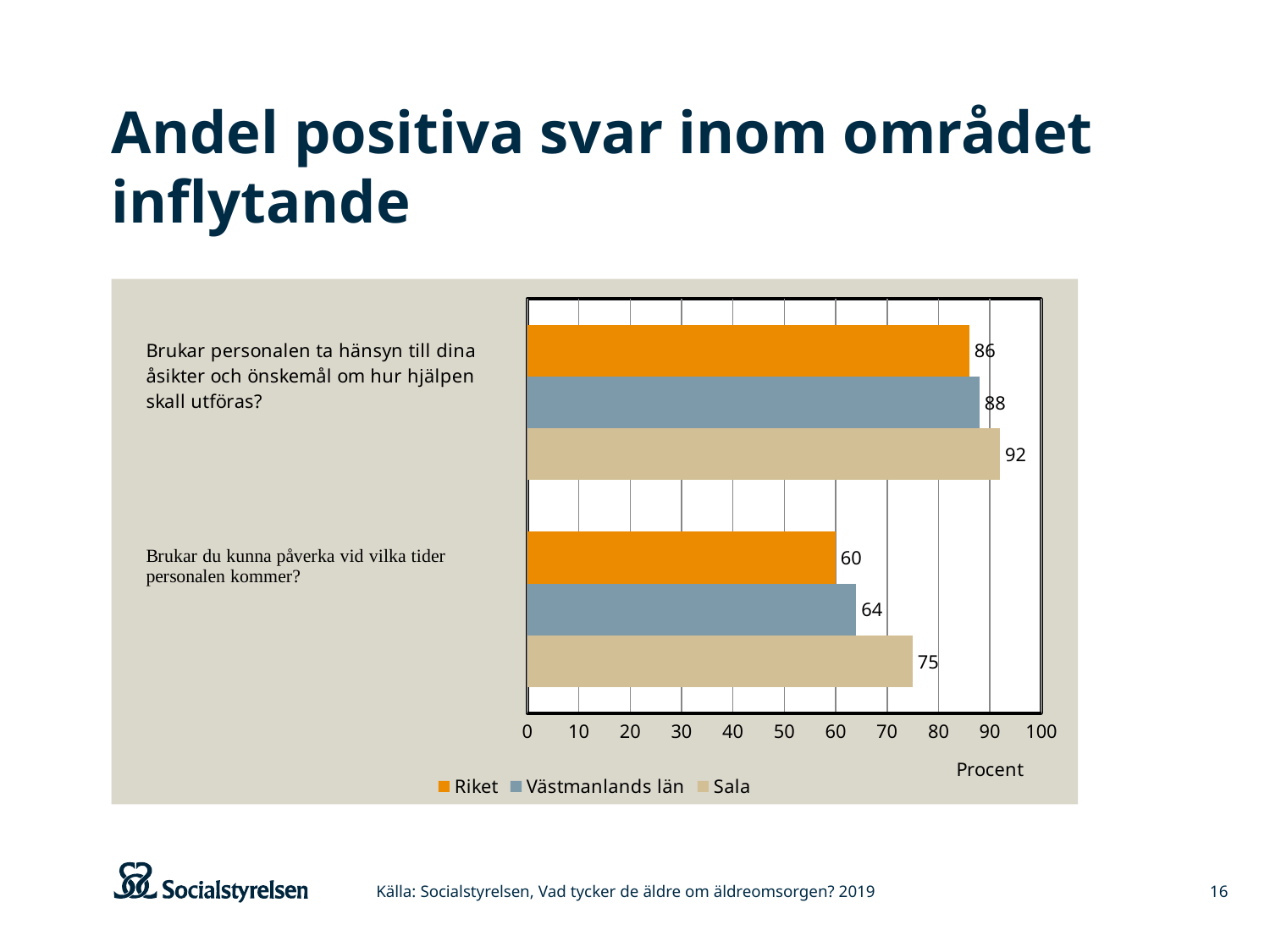
What is the label on the horizontal axis of the chart? Procent What is the difference between Sala and Riket on the question "Brukar du kunna påverka vid vilka tider personalen kommer?"? 15 Which series has the highest value on the question "Brukar du kunna påverka vid vilka tider personalen kommer?"? Sala How many questions (categories) are shown on the chart? 2 What is the value for Västmanlands län on the question "Brukar du kunna påverka vid vilka tider personalen kommer?"? 64 Which is larger: the Riket value for "Brukar personalen ta hänsyn till dina åsikter..." or the Sala value for "Brukar du kunna påverka vid vilka tider personalen kommer?"? Riket value for "Brukar personalen ta hänsyn till dina åsikter..." What is the value for Riket on the question "Brukar du kunna påverka vid vilka tider personalen kommer?"? 60 What kind of chart is shown on the slide? Bar chart Which series has the lowest value on the question "Brukar personalen ta hänsyn till dina åsikter och önskemål om hur hjälpen skall utföras?"? Riket How many series does the legend list? 3 What is the difference between Sala and Västmanlands län on the question "Brukar personalen ta hänsyn till dina åsikter och önskemål om hur hjälpen skall utföras?"? 4 What is the value for Sala on the question "Brukar personalen ta hänsyn till dina åsikter och önskemål om hur hjälpen skall utföras?"? 92